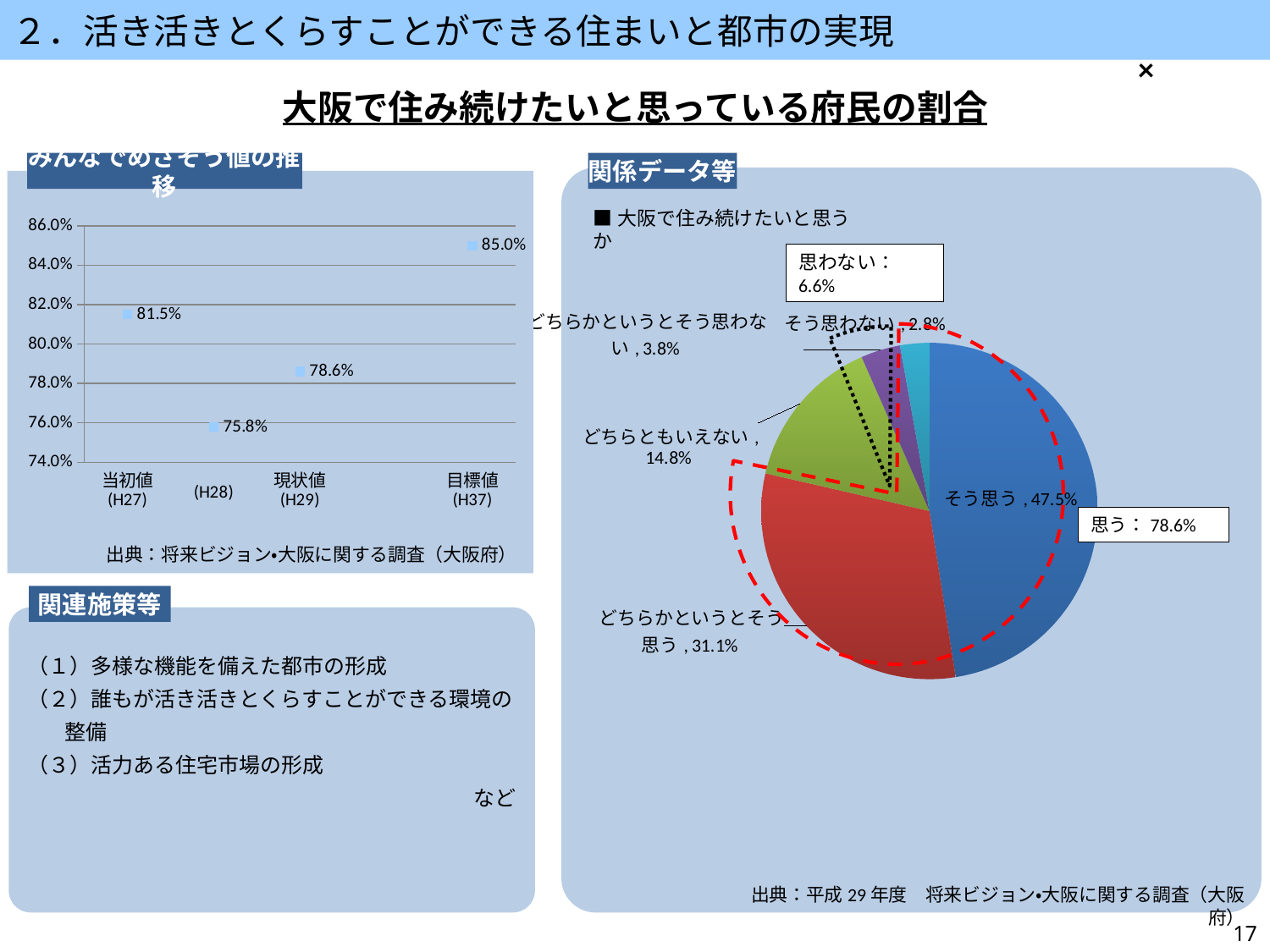
In the pie chart on the right, which is larger: どちらかというとそう思う or どちらともいえない? どちらかというとそう思う In the left chart titled みんなでめざそう値の推移, what is the value for 当初値 (H27)? 81.5% In the left chart titled みんなでめざそう値の推移, how many data points are plotted? 4 In the pie chart on the right, what share is labelled どちらともいえない? 14.8% In the left chart titled みんなでめざそう値の推移, what is the difference between the 目標値 (H37) value and the 現状値 (H29) value? 6.4% In the pie chart on the right, which slice is the smallest? そう思わない In the pie chart on the right, what share is labelled そう思う? 47.5% In the pie chart on the right, how many slices are there? 5 In the left chart titled みんなでめざそう値の推移, which category has the lowest value? H28 In the left chart titled みんなでめざそう値の推移, which category has the highest value? 目標値 (H37) In the left chart titled みんなでめざそう値の推移, what is the value for 目標値 (H37)? 85.0% What kind of chart is shown on the right side of the slide? Pie chart